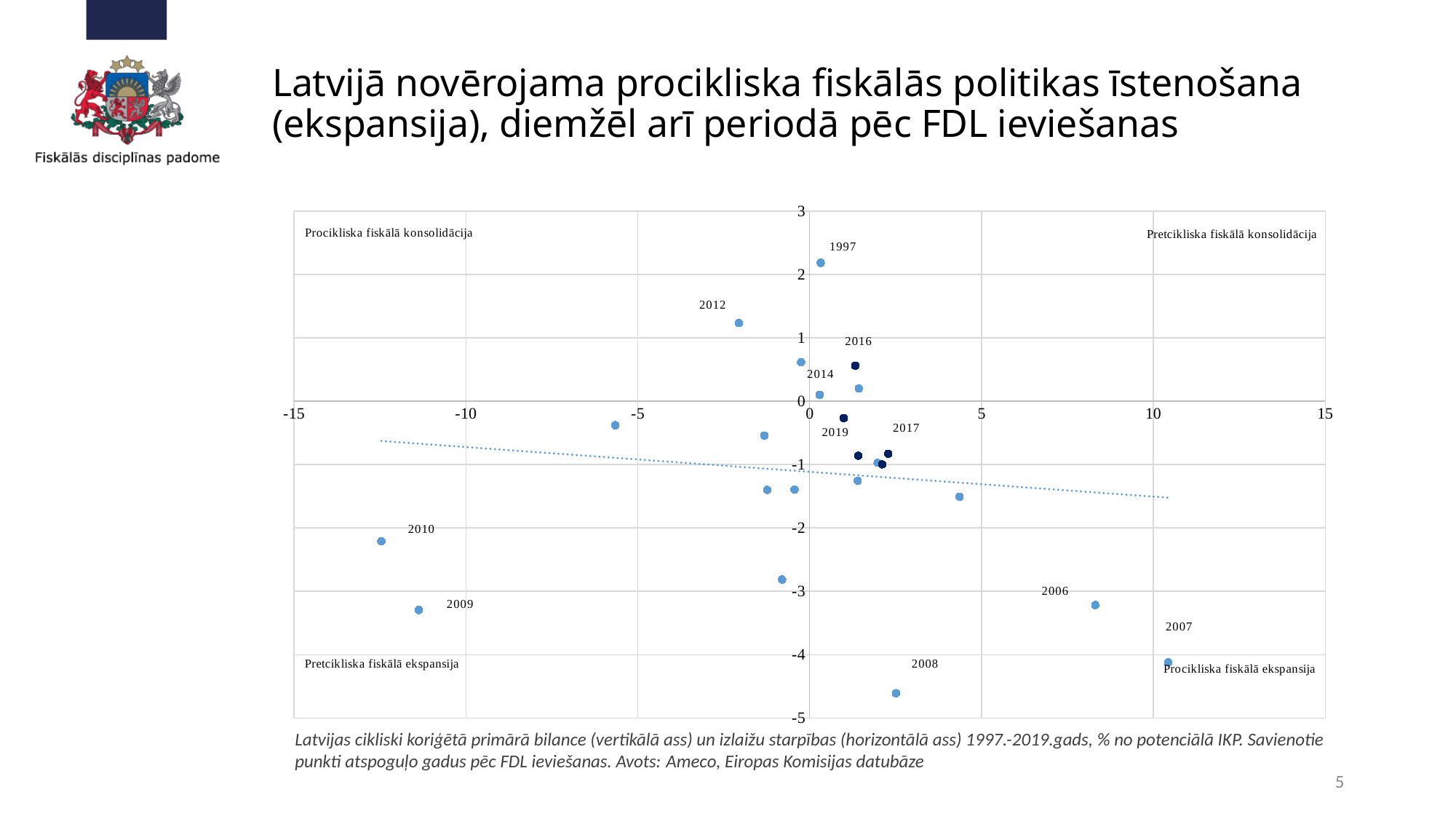
Is the vertical-axis value for 2008 greater or less than -4? less Which labelled year has the highest value on the vertical axis? 1997 Is the horizontal-axis value for 2010 greater or less than -10? less Which labelled year lies furthest to the right on the horizontal axis? 2007 What kind of chart is shown on the slide? scatter chart Does the dotted trend line rise or fall from left to right? falls Which labelled year has the lowest value on the vertical axis? 2008 Which has the larger horizontal-axis value, 2006 or 2007? 2007 Which labelled year lies furthest to the left on the horizontal axis? 2010 Is the vertical-axis value for 1997 greater or less than 2? greater What label is written in the top-left quadrant of the chart? Procikliska fiskālā konsolidācija